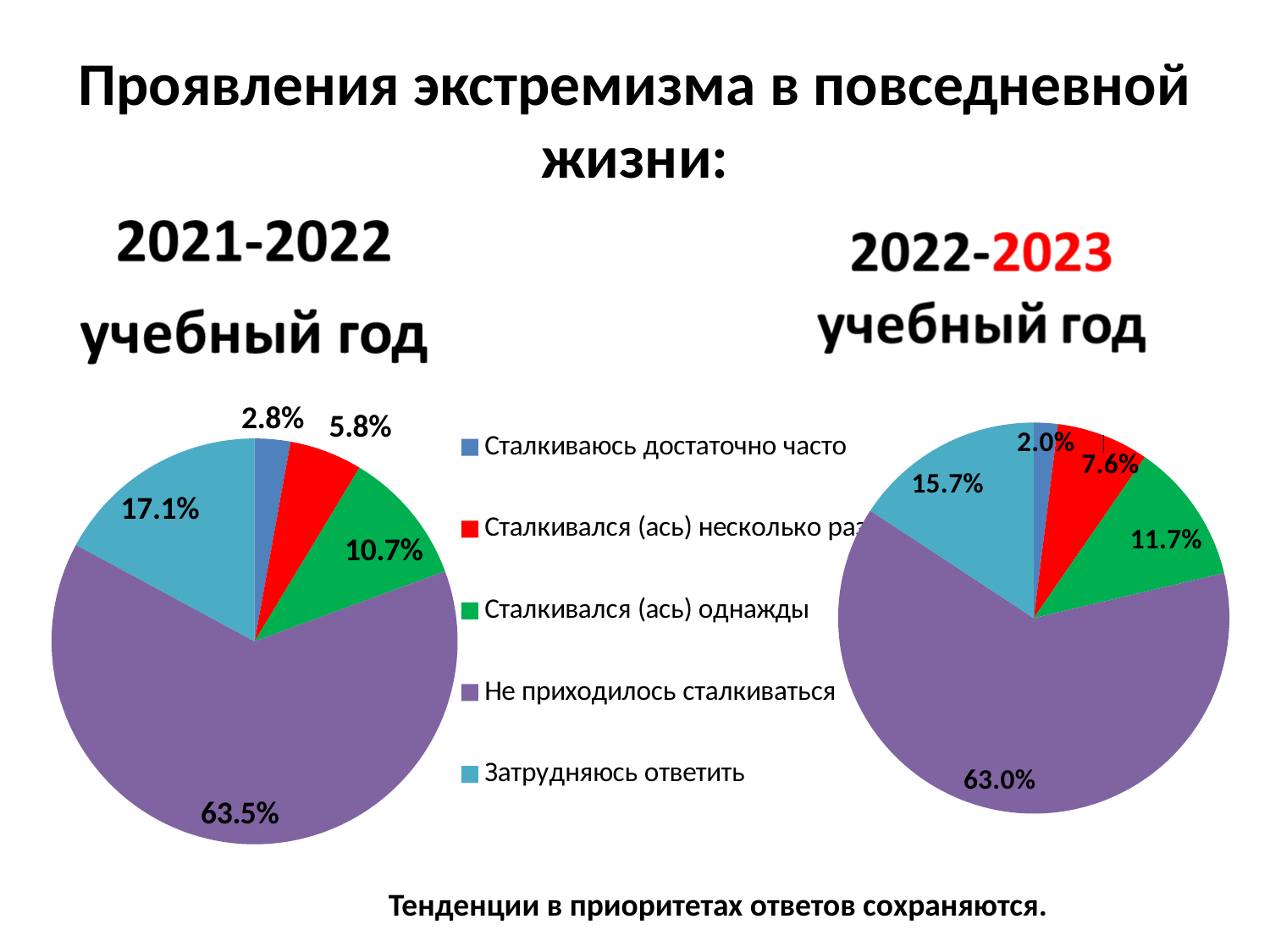
What type of chart is used for the 2022-2023 учебный год data? Pie chart In the 2022-2023 учебный год pie chart, what share is labelled for 'Сталкиваюсь достаточно часто'? 2.0% Which chart shows a larger share for 'Затрудняюсь ответить': 2021-2022 or 2022-2023? 2021-2022 In the 2022-2023 учебный год pie chart, what share is labelled for the slice 'Сталкивался (ась) однажды'? 11.7% In the legend, which colour represents 'Сталкивался (ась) однажды'? Green How many slices does the 2021-2022 учебный год pie chart have? 5 What is the difference between the 'Сталкивался (ась) несколько раз' shares in the 2022-2023 chart (7.6%) and the 2021-2022 chart (5.8%)? 1.8% In the 2021-2022 учебный год pie chart, what share is labelled for 'Затрудняюсь ответить'? 17.1% How many entries does the legend between the two charts list? 5 In the 2022-2023 учебный год pie chart, which category has the largest slice? Не приходилось сталкиваться In the 2021-2022 учебный год pie chart, which category has the smallest slice? Сталкиваюсь достаточно часто In the 2021-2022 учебный год pie chart, what share is labelled for the slice 'Не приходилось сталкиваться'? 63.5%